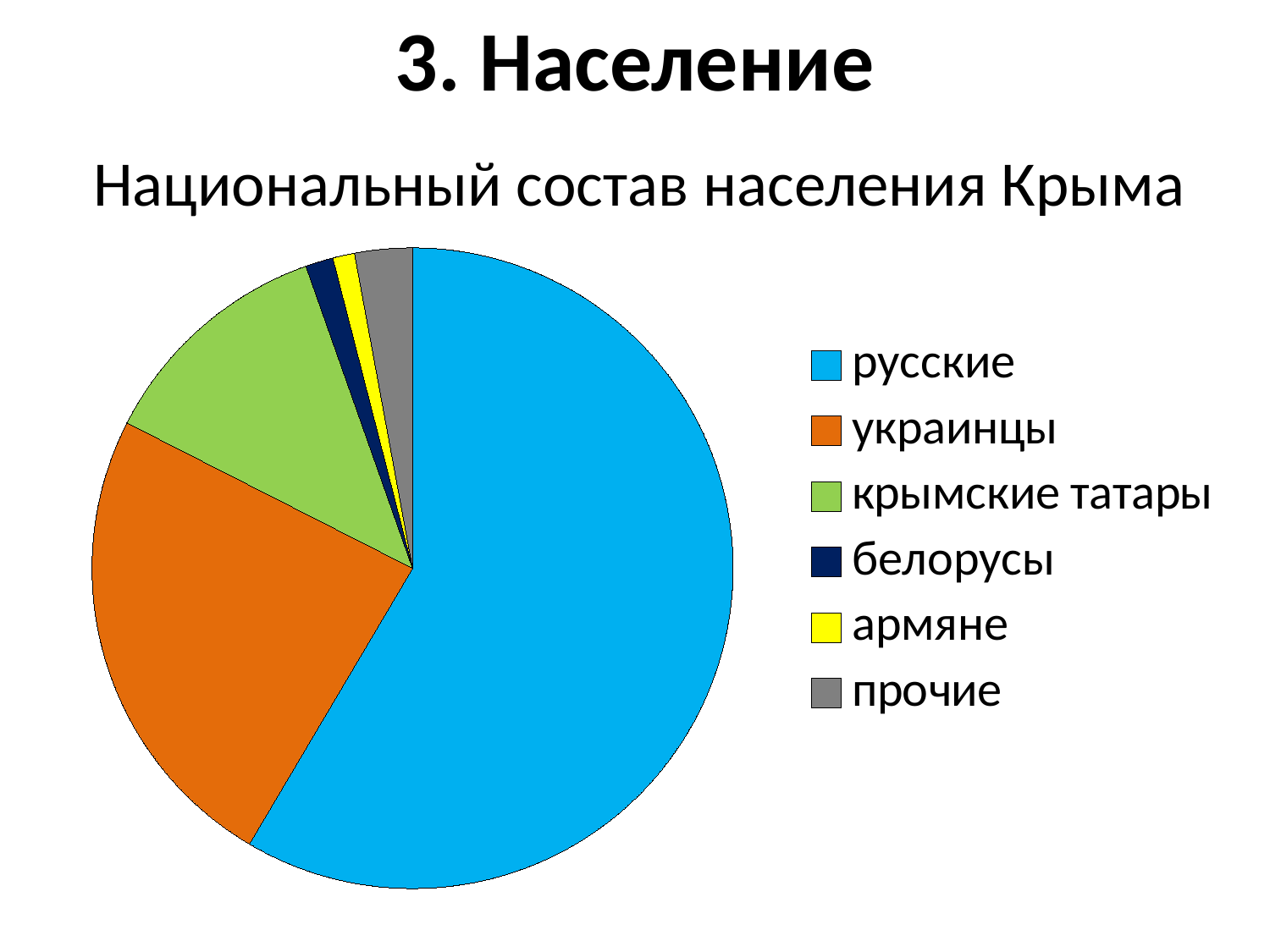
How many categories does the legend of the pie chart list? 6 Which slice is larger, русские or украинцы? русские Does the slice for русские take up more or less than half of the pie? more What kind of chart is shown on the slide? pie chart Which slice is larger, украинцы or крымские татары? украинцы Which slice is larger, прочие or белорусы? прочие What is the title of the chart? Национальный состав населения Крыма Which category is the second largest slice of the pie? украинцы What colour is the slice for русские? light blue Which category has the largest slice of the pie? русские